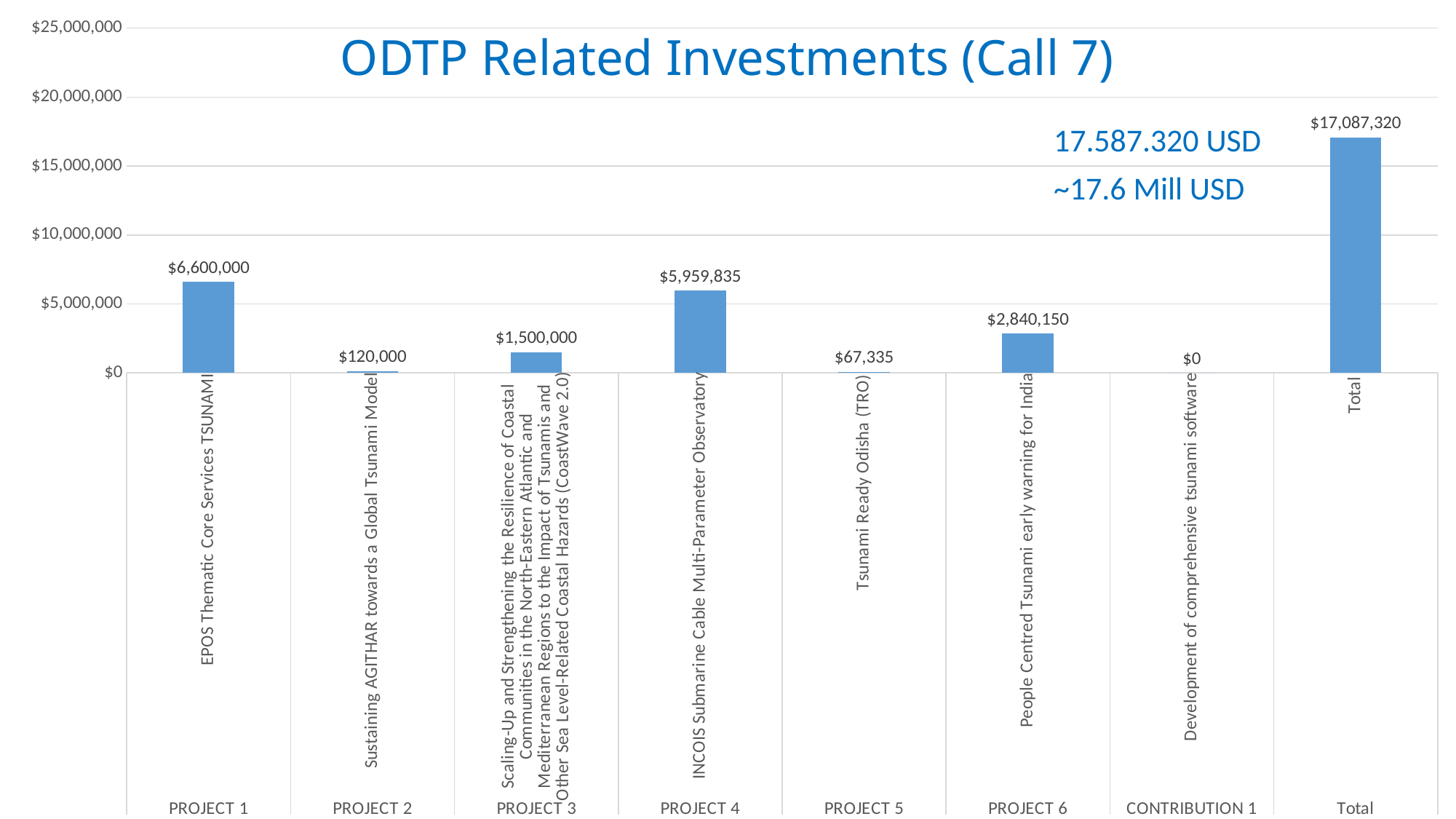
What is the title of the chart? ODTP Related Investments (Call 7) Which is larger, the value for PROJECT 3 or the value for PROJECT 6? PROJECT 6 What is the value for PROJECT 1 (EPOS Thematic Core Services TSUNAMI)? $6,600,000 Excluding the Total bar, which project has the highest investment? PROJECT 1 What is the value shown for the Total bar? $17,087,320 What is the value for CONTRIBUTION 1 (Development of comprehensive tsunami software)? $0 Is the value for PROJECT 4 greater or less than $5,000,000? greater Which category has the lowest value? CONTRIBUTION 1 How many categories are shown on the x axis? 8 What is the value for PROJECT 4 (INCOIS Submarine Cable Multi-Parameter Observatory)? $5,959,835 What is the value for PROJECT 6 (People Centred Tsunami early warning for India)? $2,840,150 What is the difference between the values for PROJECT 1 and PROJECT 4? $640,165